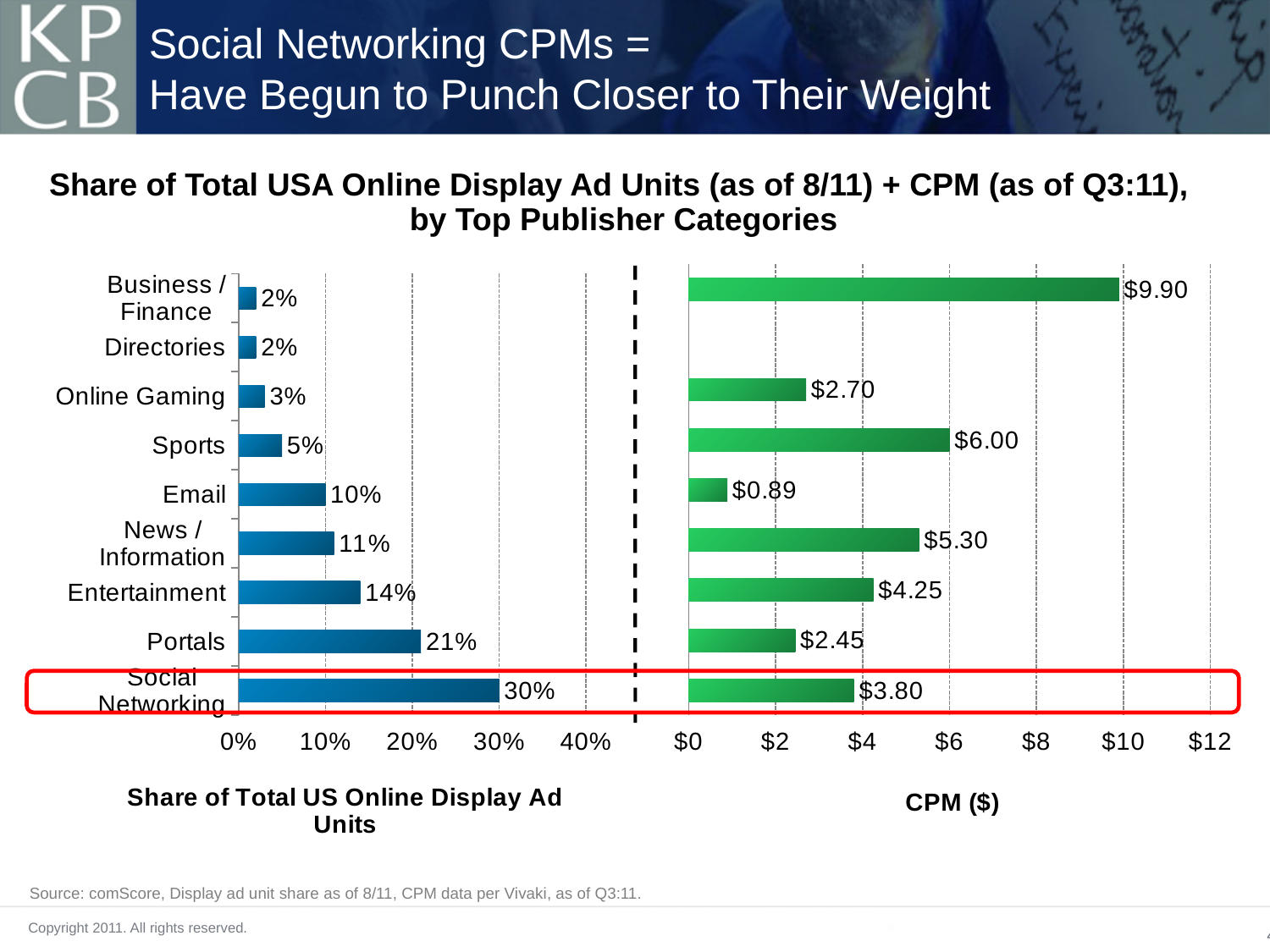
In the left chart (Share of Total US Online Display Ad Units), what is the difference between the shares for Social Networking and Portals? 9% In the left chart (Share of Total US Online Display Ad Units), which has a larger share, Email or Sports? Email How many publisher categories are listed on the left chart (Share of Total US Online Display Ad Units)? 9 In the right chart (CPM ($)), which category has the highest CPM? Business / Finance What type of chart is used for the CPM ($) chart on the right? Bar chart In the right chart (CPM ($)), what is the difference between the CPM for Sports and the CPM for Social Networking? $2.20 In the right chart (CPM ($)), which category has the lowest CPM? Email In the right chart (CPM ($)), which has a higher CPM, Entertainment or Portals? Entertainment In the left chart (Share of Total US Online Display Ad Units), which category has the highest share? Social Networking In the right chart (CPM ($)), what is the CPM for Email? $0.89 In the right chart (CPM ($)), what is the CPM for Business / Finance? $9.90 In the left chart (Share of Total US Online Display Ad Units), what is the value for Social Networking? 30%